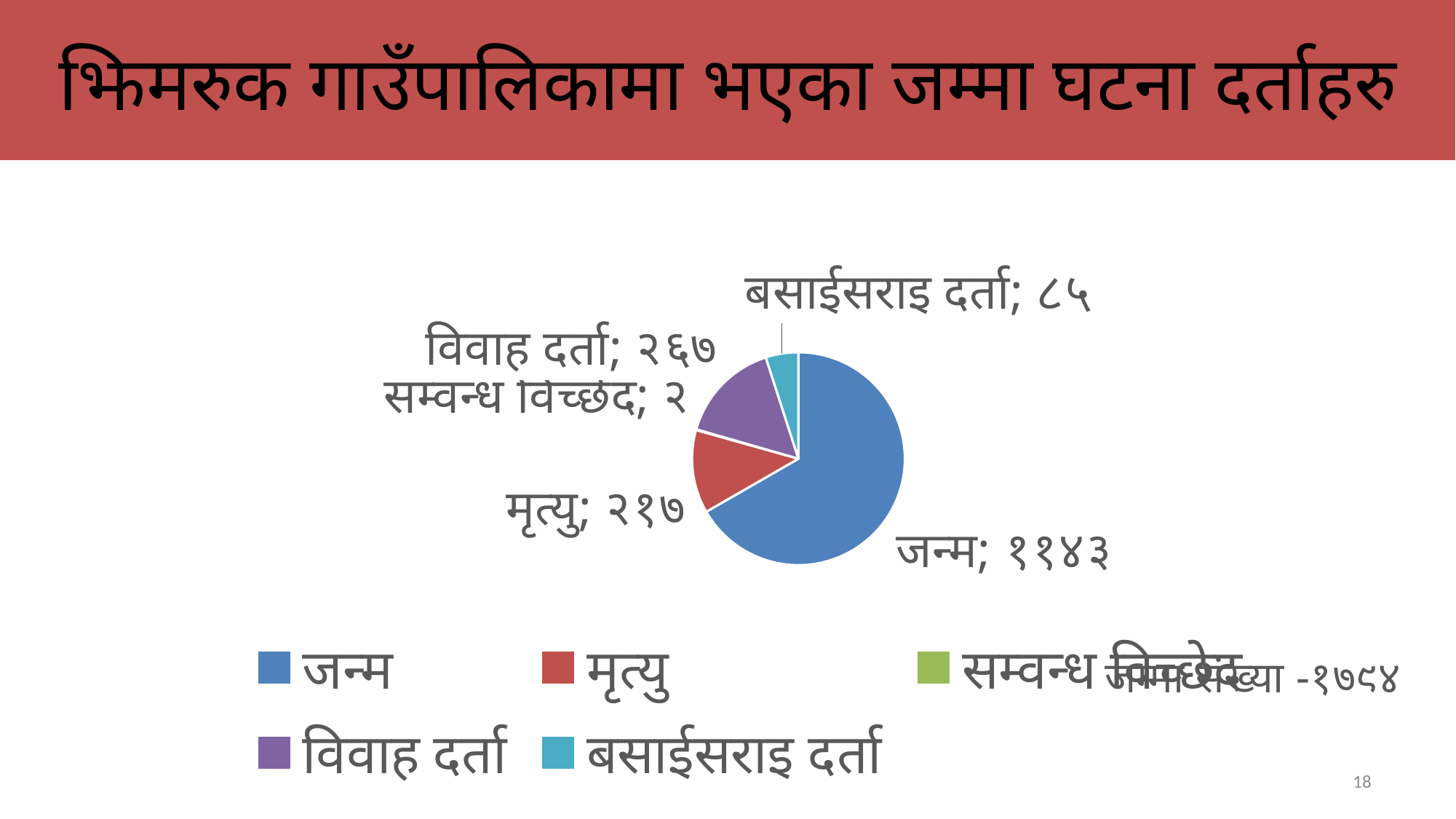
What is the value for विवाह दर्ता in the pie chart? २६७ Which category has the largest slice in the pie chart? जन्म What is the difference between the values for विवाह दर्ता and मृत्यु? ५० (50) What is the value for सम्वन्ध विच्छेद in the pie chart? २ Which is larger, विवाह दर्ता or मृत्यु? विवाह दर्ता How many categories does the legend of the pie chart list? 5 What is the value for मृत्यु in the pie chart? २१७ Which category has the smallest slice in the pie chart? सम्वन्ध विच्छेद What colour is the जन्म slice in the pie chart? Blue What is the value for बसाईसराइ दर्ता in the pie chart? ८५ What kind of chart is shown on the slide? Pie chart What is the value for जन्म in the pie chart? ११४३